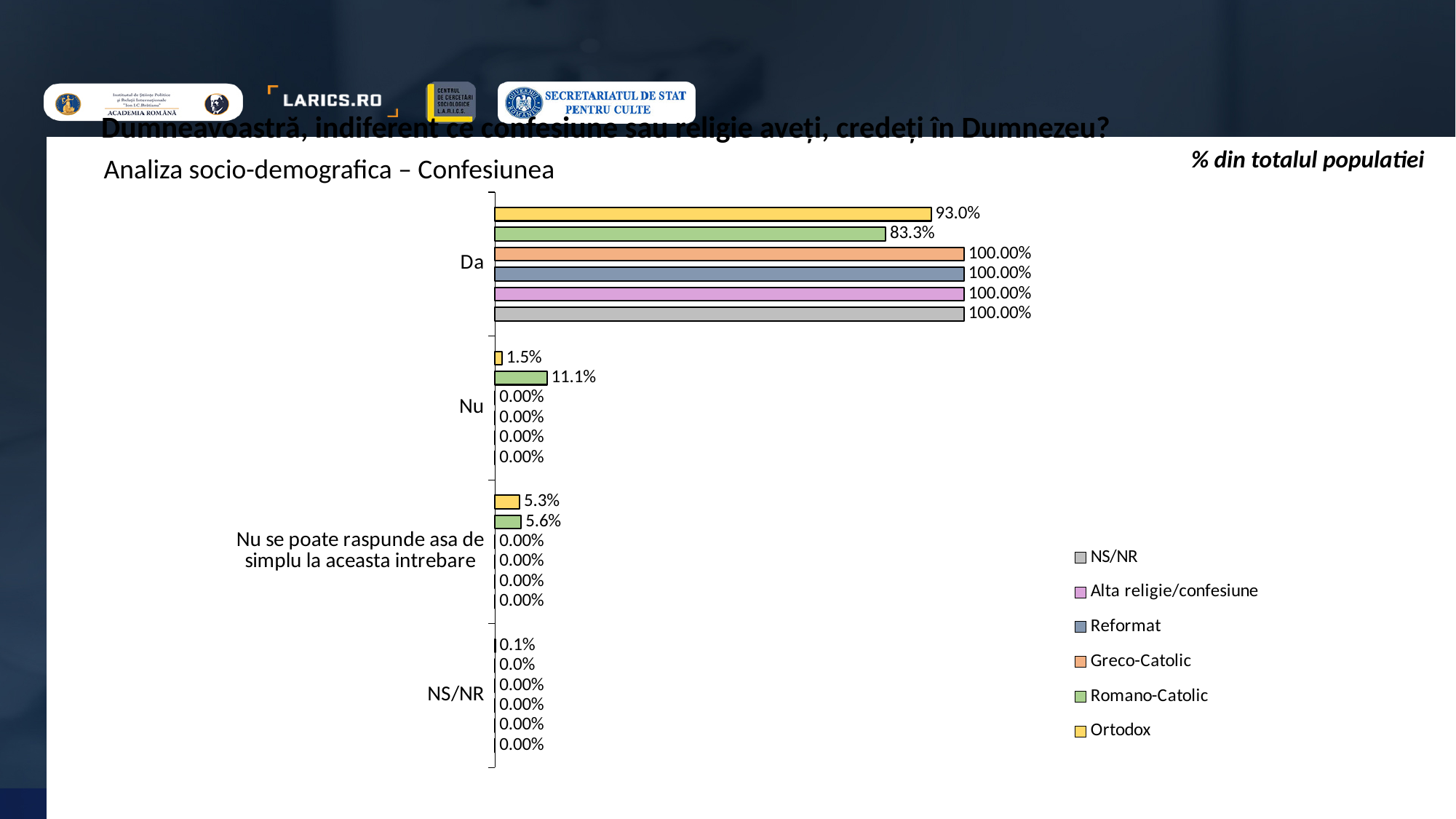
In the 'Nu' category, which is larger: the Ortodox value or the Romano-Catolic value? Romano-Catolic How many series does the legend list? 6 Which series has the lowest value in the 'Da' category? Romano-Catolic What is the value for Romano-Catolic in the 'Da' category? 83.3% What is the value for Ortodox in the 'Nu se poate raspunde asa de simplu la aceasta intrebare' category? 5.3% What is the difference between the Ortodox and Romano-Catolic values in the 'Da' category? 9.7% What is the value for Ortodox in the 'NS/NR' category? 0.1% How many response categories are shown on the vertical axis? 4 What is the value for Greco-Catolic in the 'Da' category? 100.00% What is the value for Ortodox in the 'Da' category? 93.0% What is the value for Romano-Catolic in the 'Nu' category? 11.1% What kind of chart is shown on the slide? bar chart